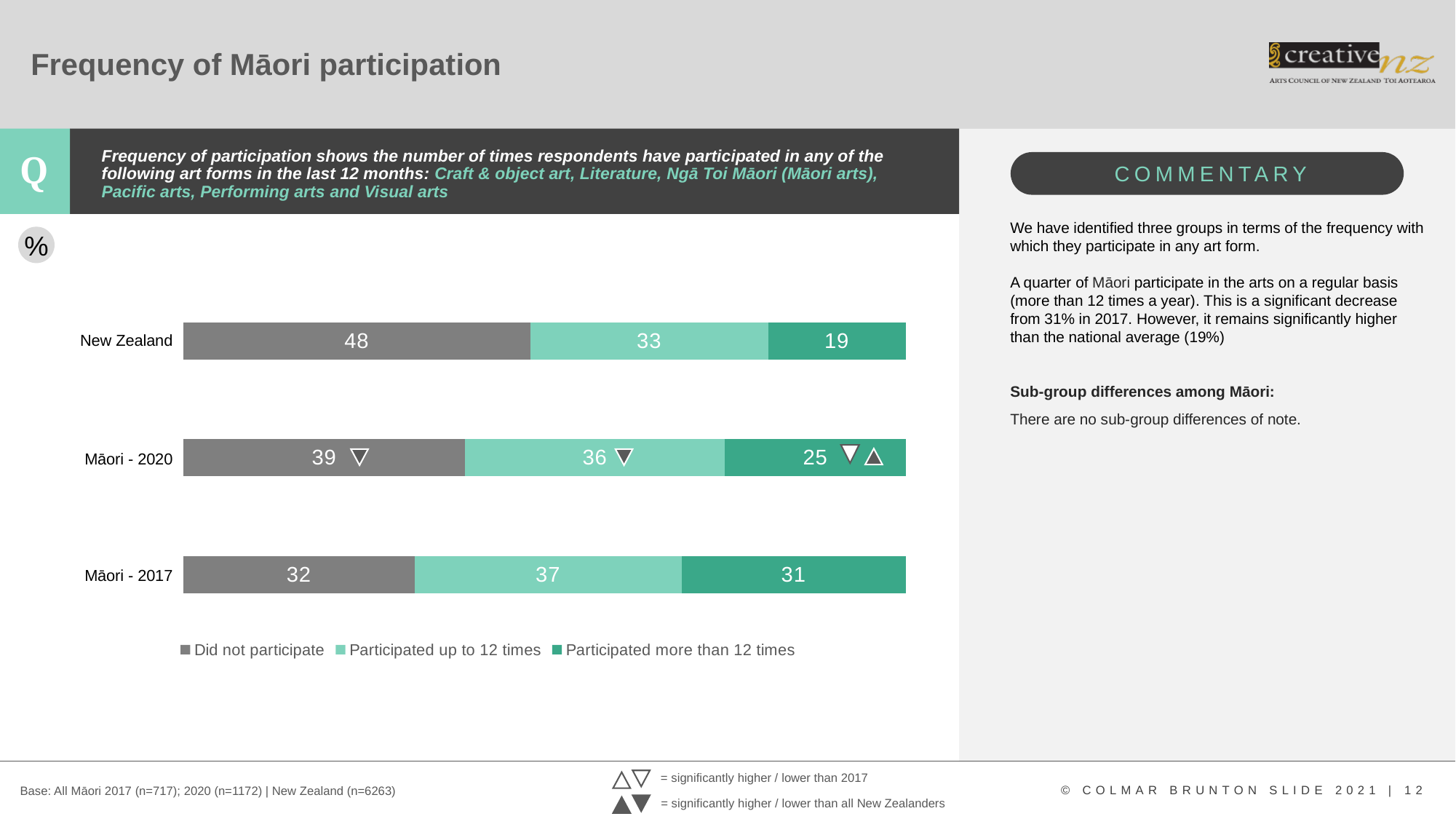
How many categories (bars) are shown in the chart? 3 Which legend entry is shown in grey? Did not participate What kind of chart is shown on the slide? Stacked bar chart Which category has the lowest value for 'Did not participate'? Māori - 2017 What is the value for 'Participated up to 12 times' for Māori - 2017? 37 Which is larger: 'Participated more than 12 times' for Māori - 2020 or for New Zealand? Māori - 2020 What is the value for 'Participated more than 12 times' for Māori - 2020? 25 What percentage of New Zealand respondents did not participate? 48 What is the difference between the 'Did not participate' values for New Zealand and Māori - 2020? 9 What is the total of the stacked bar for Māori - 2020? 100 Which category has the highest value for 'Participated more than 12 times'? Māori - 2017 How many series does the legend list? 3